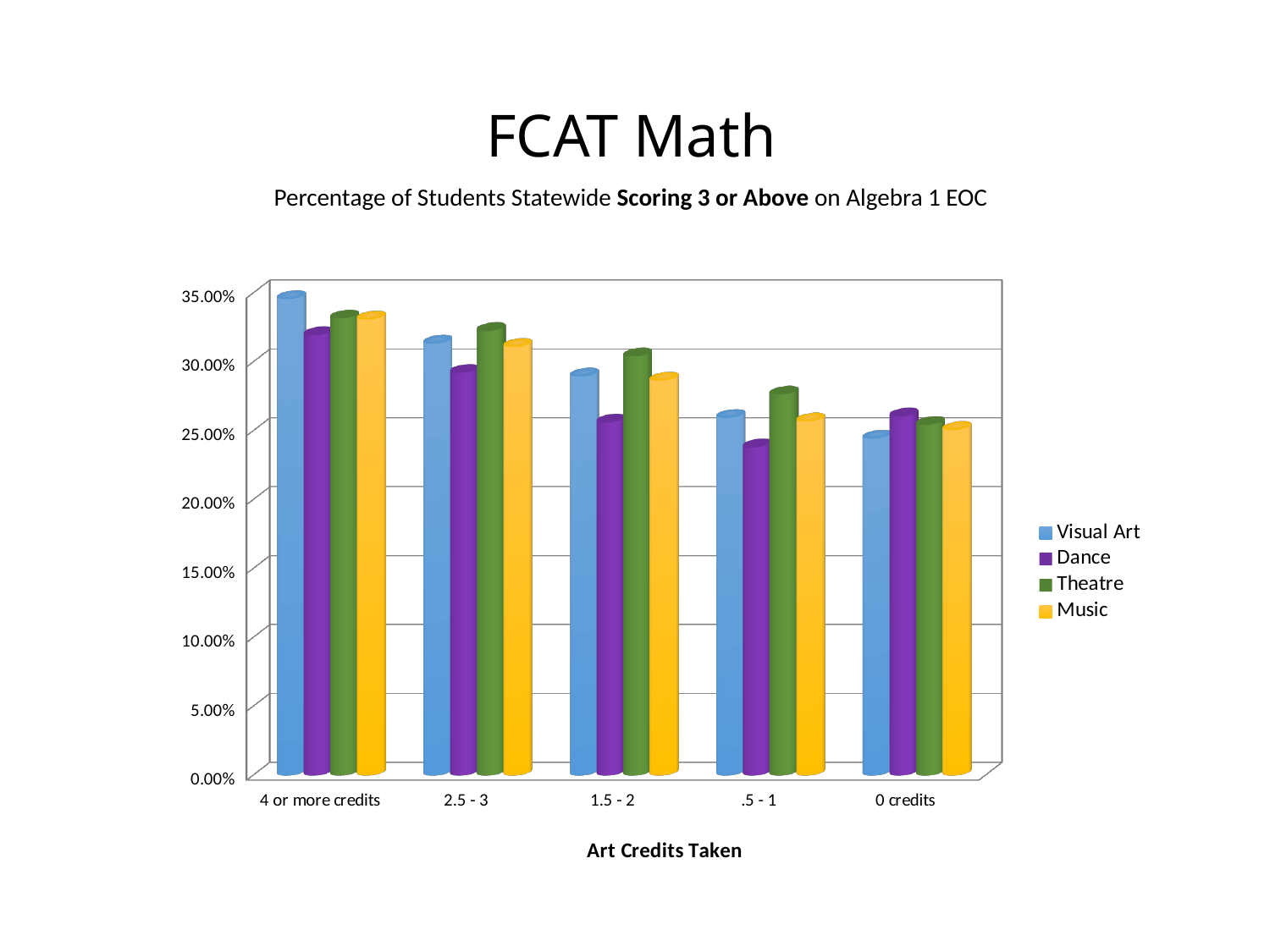
Is the Visual Art value for 4 or more credits greater or less than 30.00%? greater For which category is the Dance bar lowest? .5 - 1 Do the Visual Art values rise or fall moving from 4 or more credits to 0 credits along the x axis? Fall How many series does the legend list? 4 For which category is the Visual Art bar lowest? 0 credits How many categories are shown along the x axis? 5 What is the title of the x axis? Art Credits Taken Which is larger for 4 or more credits, Visual Art or Dance? Visual Art What kind of chart is shown on the slide? Bar chart For which category is the Visual Art bar highest? 4 or more credits Which series is shown in purple in the legend? Dance Is the Dance value for .5 - 1 credits greater or less than 25.00%? less